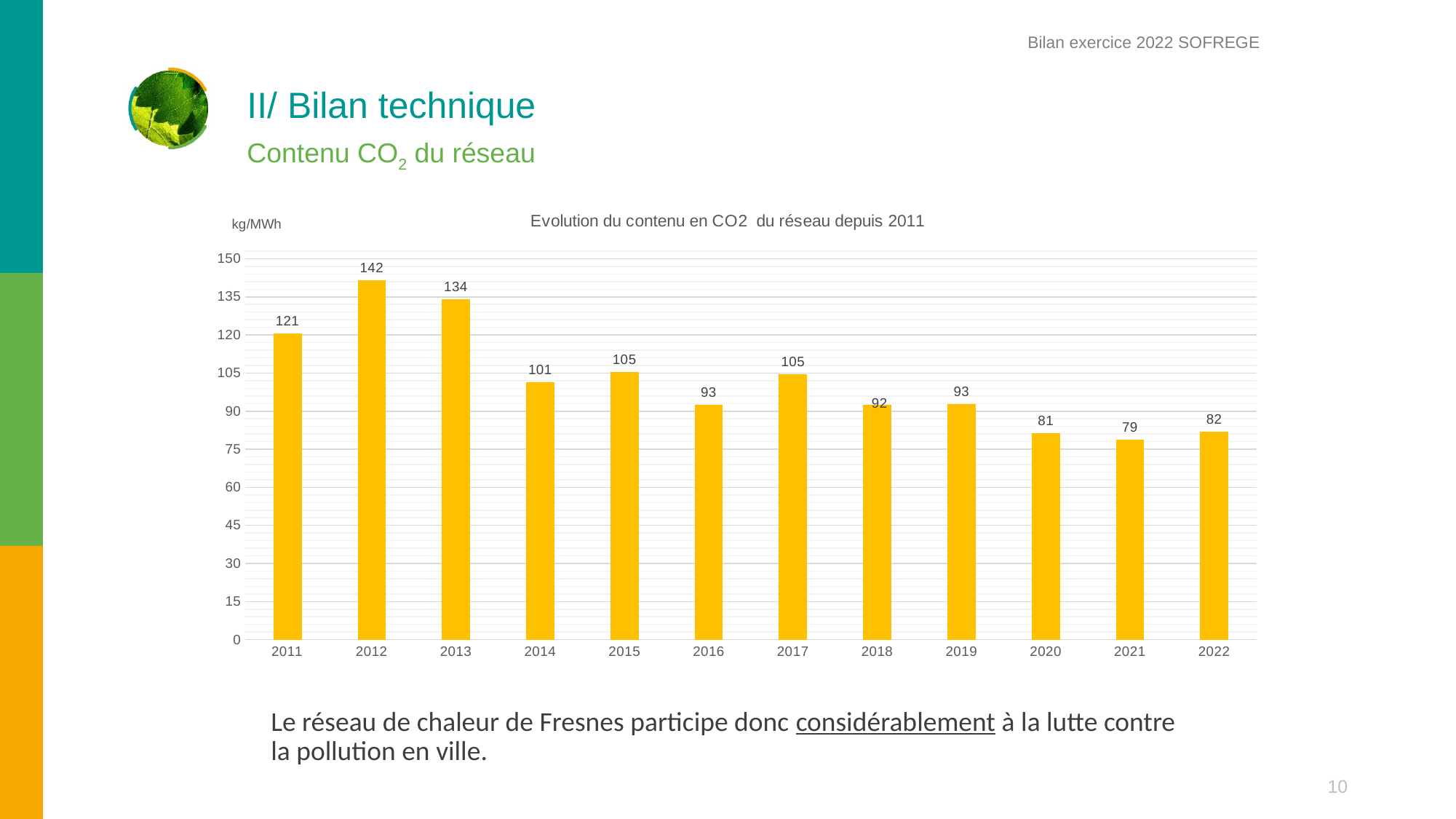
What is the difference between the values for 2011 and 2014? 20 What is the title of the chart? Evolution du contenu en CO2 du réseau depuis 2011 Which is larger, the value for 2013 or the value for 2017? 2013 What is the difference between the values for 2012 and 2022? 60 Is the value for 2016 greater or less than 105? less What is the value shown for 2018? 92 What is the CO2 content value for 2012? 142 Which year has the lowest CO2 content? 2021 What is the CO2 content value for 2022? 82 How many years are shown on the x axis? 12 Which year has the highest CO2 content? 2012 What kind of chart is shown on the slide? bar chart